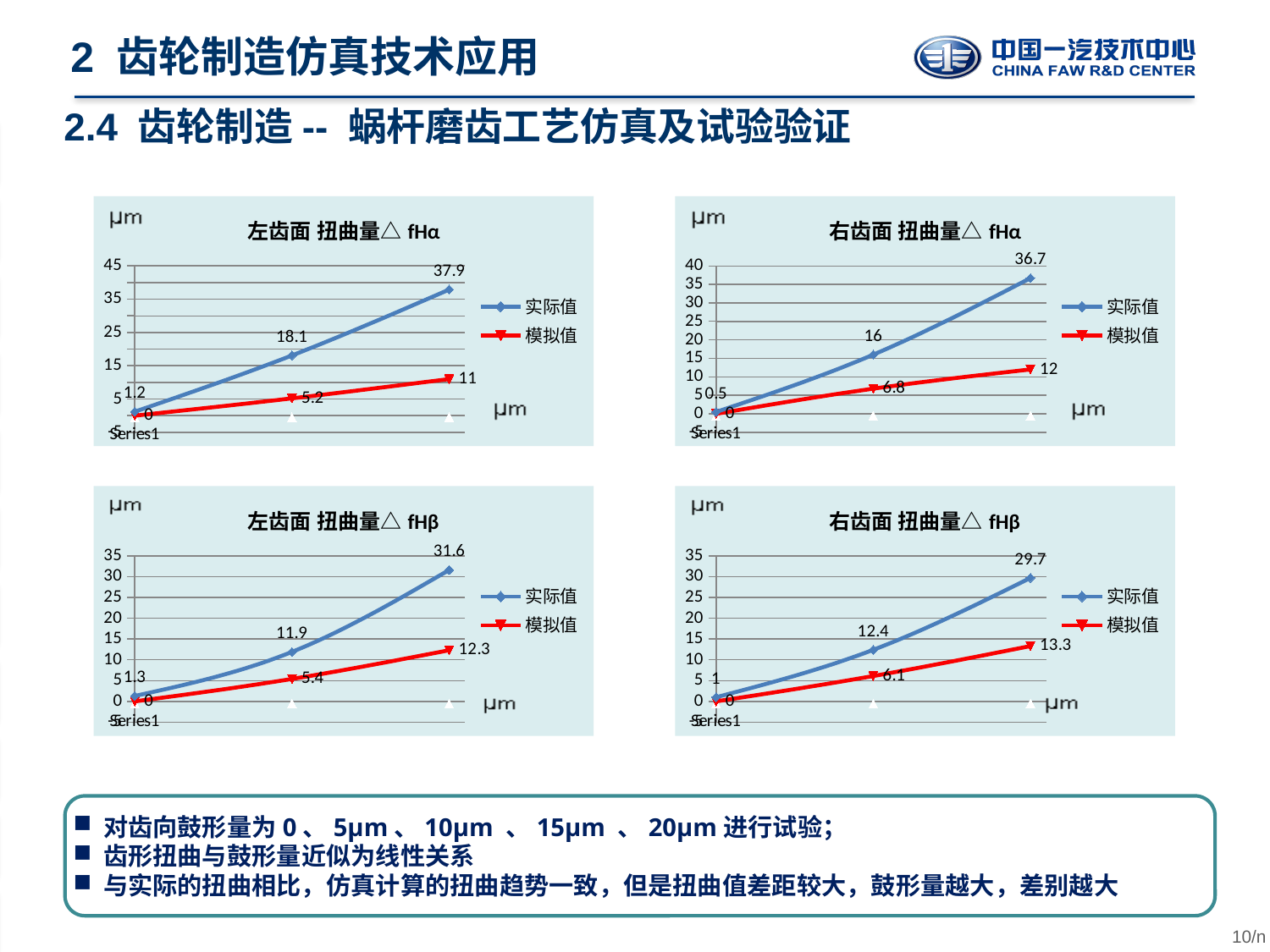
In the chart titled 左齿面 扭曲量△ fHα, what is the highest labelled value of the 实际值 series? 37.9 In the chart titled 右齿面 扭曲量△ fHα, what is the highest labelled value of the 模拟值 series? 12 In the chart titled 左齿面 扭曲量△ fHα, do the 实际值 values rise or fall from left to right? rise In the chart titled 左齿面 扭曲量△ fHβ, what is the value of the rightmost point of the 实际值 series? 31.6 In the chart titled 左齿面 扭曲量△ fHβ, what is the value of the middle point of the 模拟值 series? 5.4 In the chart titled 右齿面 扭曲量△ fHβ, which series has the larger rightmost value, 实际值 or 模拟值? 实际值 What kind of chart is the chart titled 右齿面 扭曲量△ fHα? line chart In the chart titled 左齿面 扭曲量△ fHα, what is the difference between the rightmost 实际值 point (37.9) and the rightmost 模拟值 point (11)? 26.9 In the chart titled 左齿面 扭曲量△ fHα, what is the value of the rightmost point of the 模拟值 series? 11 How many series does the legend list in the chart titled 左齿面 扭曲量△ fHβ? 2 In the chart titled 右齿面 扭曲量△ fHβ, what is the difference between the rightmost 实际值 point (29.7) and the rightmost 模拟值 point (13.3)? 16.4 In the chart titled 右齿面 扭曲量△ fHα, what is the value of the middle point of the 实际值 series? 16